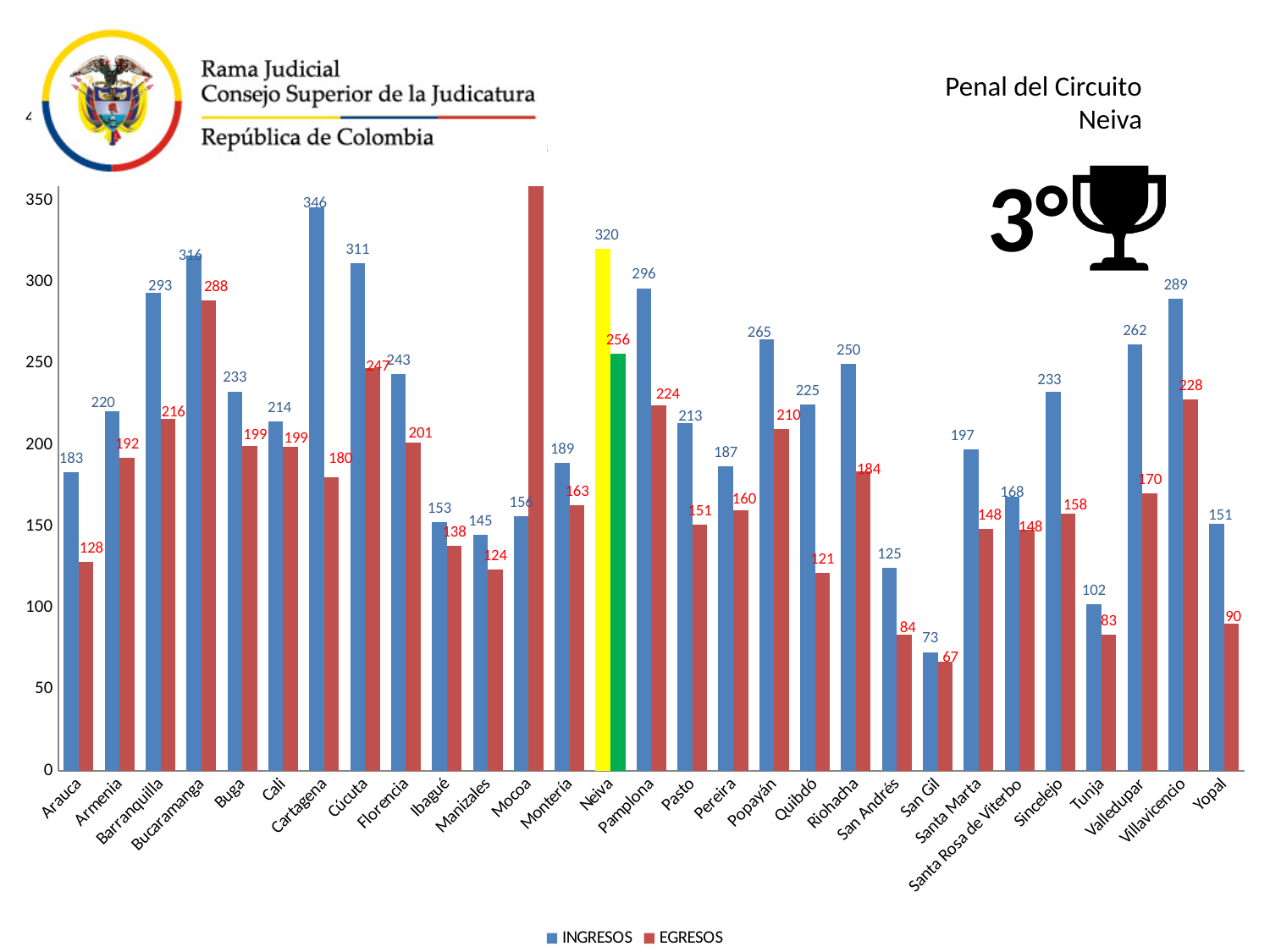
Is the EGRESOS value for Mocoa greater or less than 350? greater What is the INGRESOS value for Neiva? 320 Which is larger for Quibdó, INGRESOS or EGRESOS? INGRESOS What is the INGRESOS value for Villavicencio? 289 Which city has the lowest EGRESOS value? San Gil How many series does the legend list? 2 How many cities are shown on the x axis? 29 What is the EGRESOS value for Cúcuta? 247 Which city has the highest INGRESOS value? Cartagena Which city's bars are highlighted in yellow and green? Neiva What kind of chart is shown on the slide? bar chart What is the difference between INGRESOS and EGRESOS for Cartagena? 166